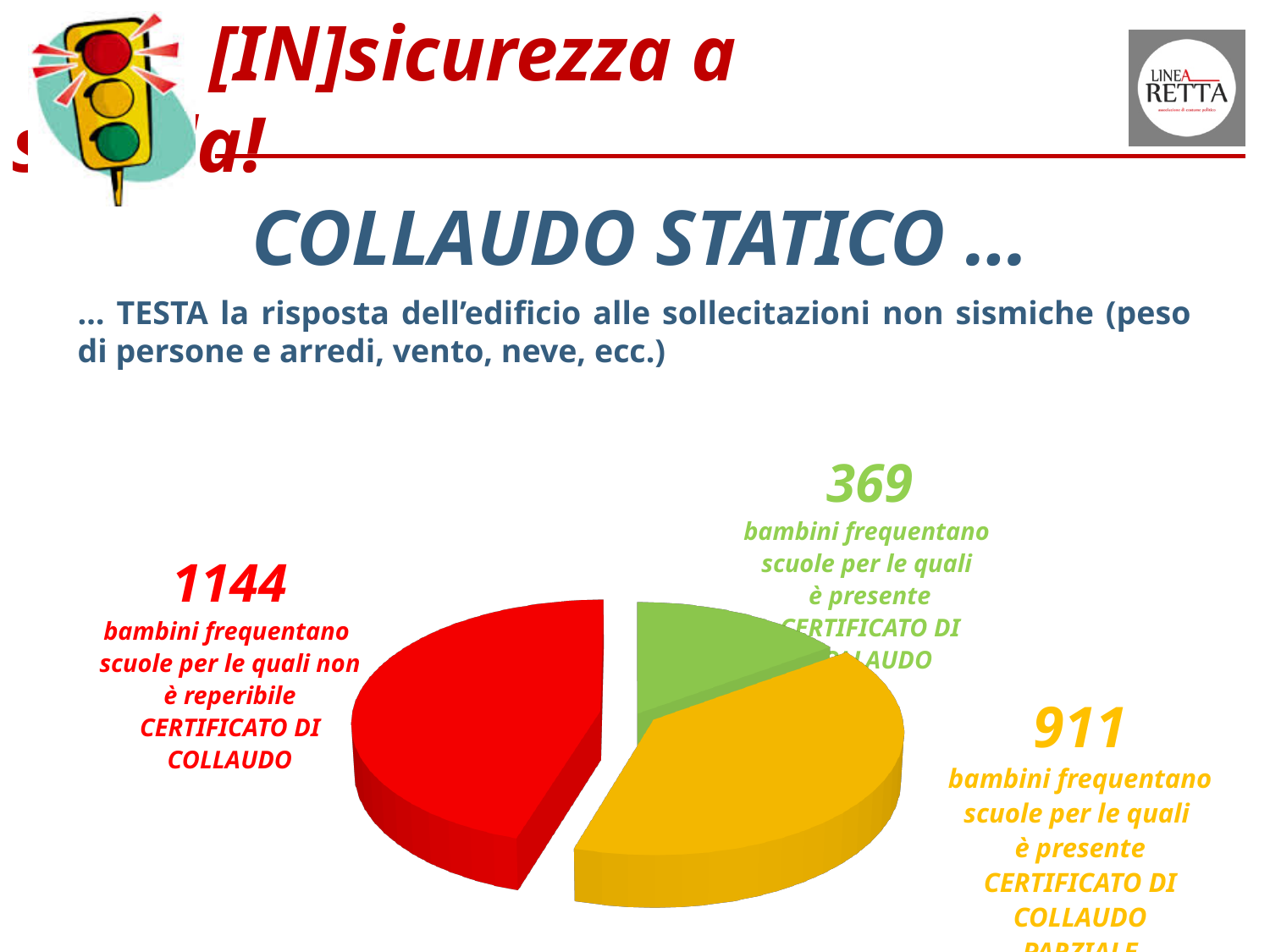
What is the difference between the number of children in the red slice (1144) and the yellow slice (911)? 233 How many slices does the pie chart have? 3 Which is larger: the number of children in schools with a partial certificate (yellow) or in schools with a full certificate present (green)? partial certificate (yellow), 911 What is the difference between the number of children in the yellow slice (911) and the green slice (369)? 542 Which slice of the pie chart represents the largest number of children? 1144 (non è reperibile certificato di collaudo) What kind of chart is shown on the slide? pie chart How many children attend schools for which a certificate of static testing is present, according to the green slice? 369 What colour is the slice representing the 1144 children in schools with no certificate of static testing? red How many children attend schools for which no certificate of static testing (certificato di collaudo) can be found, according to the red slice? 1144 How many children attend schools for which a partial certificate of static testing is present, according to the yellow slice? 911 What is the total number of children represented in the pie chart? 2424 Which slice of the pie chart represents the smallest number of children? 369 (è presente certificato di collaudo)